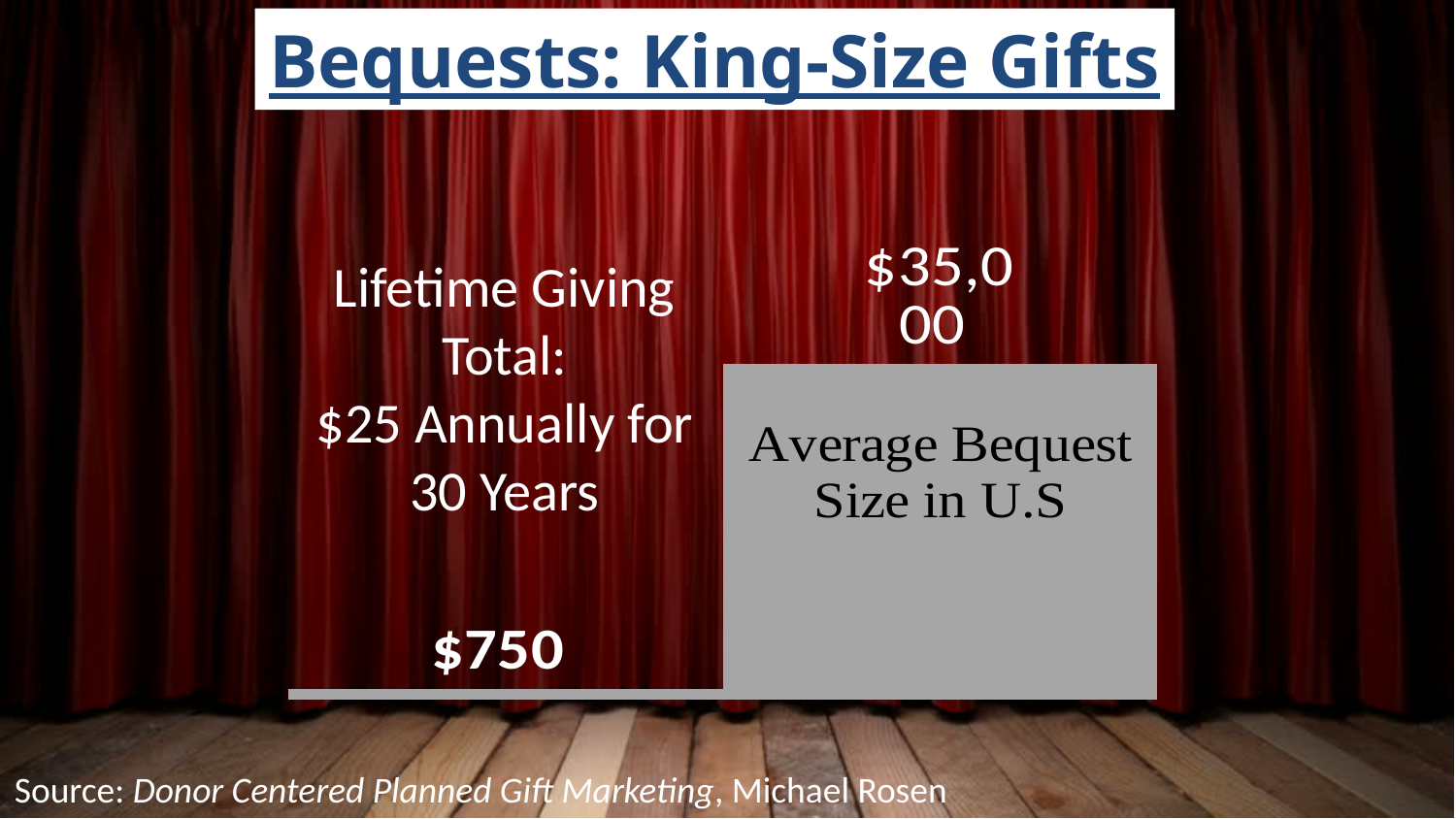
Is the Lifetime Giving Total larger or smaller than the Average Bequest Size in U.S? smaller What is the difference between the Average Bequest Size in U.S and the Lifetime Giving Total? $34,250 Which category has the higher value? Average Bequest Size in U.S How many bars are shown in the chart? 2 What is the value shown for Average Bequest Size in U.S? $35,000 What is the title of the slide containing the chart? Bequests: King-Size Gifts What is the value shown for the Lifetime Giving Total bar? $750 According to the chart, the Lifetime Giving Total is based on what annual gift over how many years? $25 annually for 30 years What kind of chart is shown on the slide? bar chart Which category has the lower value? Lifetime Giving Total